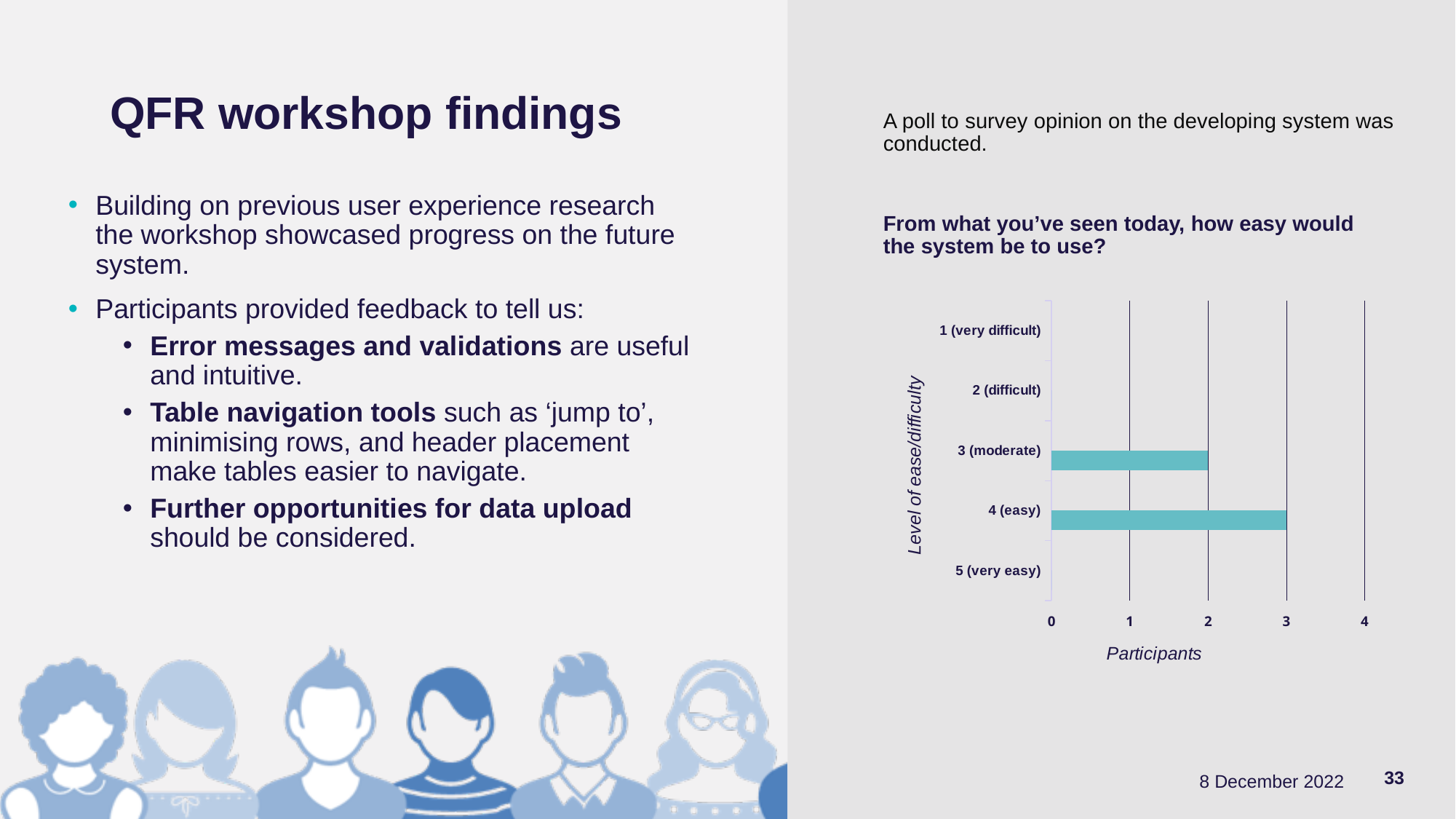
What kind of chart is used to show the poll results? Bar chart Which rating received more participants, 3 (moderate) or 4 (easy)? 4 (easy) What is the difference in participants between the 4 (easy) and 3 (moderate) ratings? 1 How many participants rated the system as 4 (easy)? 3 Which rating category has the highest number of participants? 4 (easy) How many participants rated the system as 1 (very difficult)? 0 Is the number of participants for 4 (easy) greater or less than 2? greater How many participants rated the system as 3 (moderate)? 2 What is the label of the horizontal axis of the chart? Participants How many rating categories are shown on the vertical axis of the chart? 5 What is the total number of participants across the 3 (moderate) and 4 (easy) ratings? 5 What is the label of the vertical axis of the chart? Level of ease/difficulty